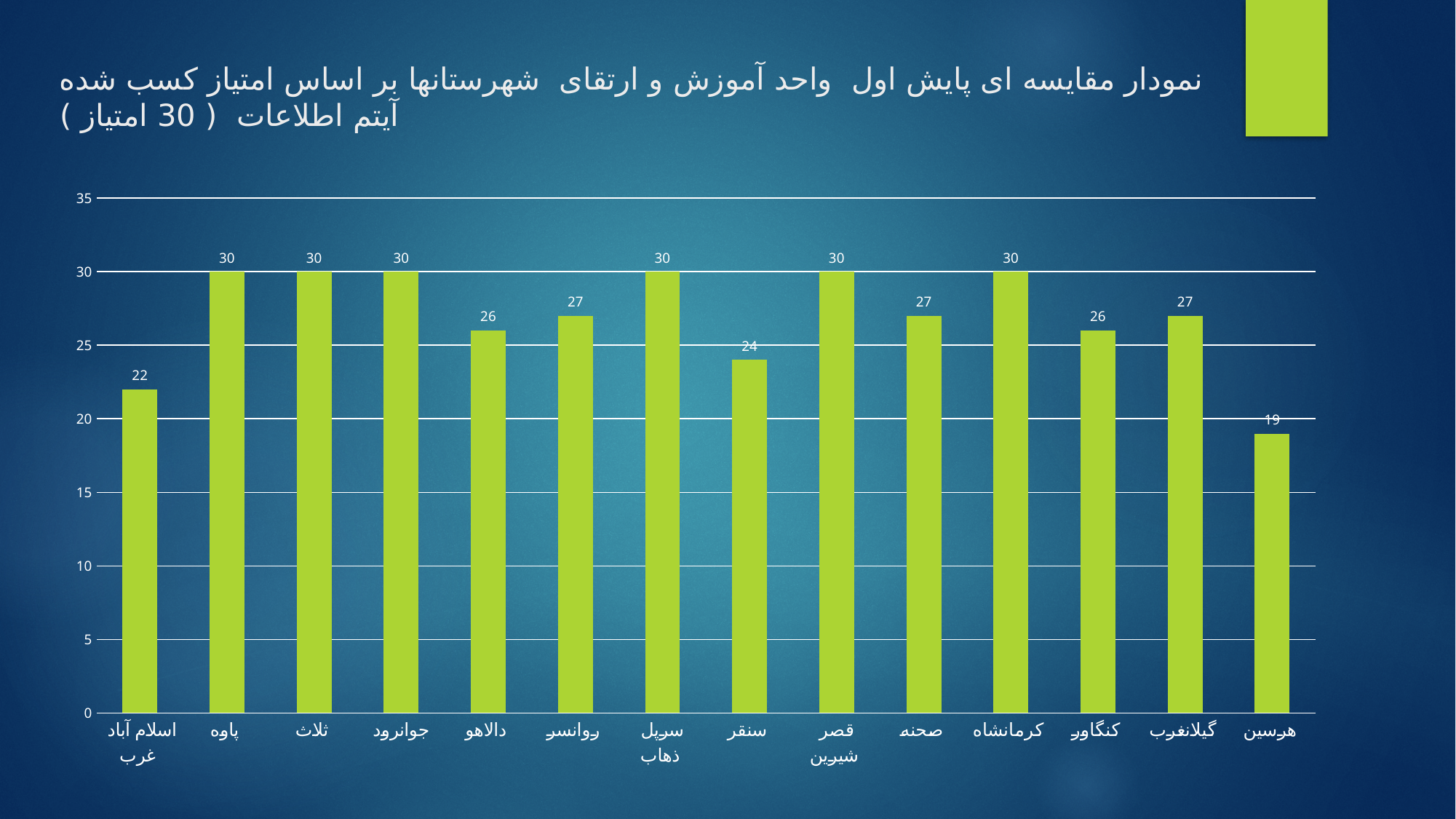
What is the difference between the values for صحنه and کنگاور? 1 What is the value for هرسین? 19 How many categories are shown on the x axis? 14 What type of chart is shown on the slide? bar chart What is the value for سنقر? 24 How many bars reach the value 30? 6 What is the difference between the values for پاوه and هرسین? 11 Which category has the lowest value? هرسین What is the highest value shown in the chart? 30 Which is larger, the value for روانسر or the value for سنقر? روانسر What is the value for اسلام آباد غرب? 22 What is the value for دالاهو? 26